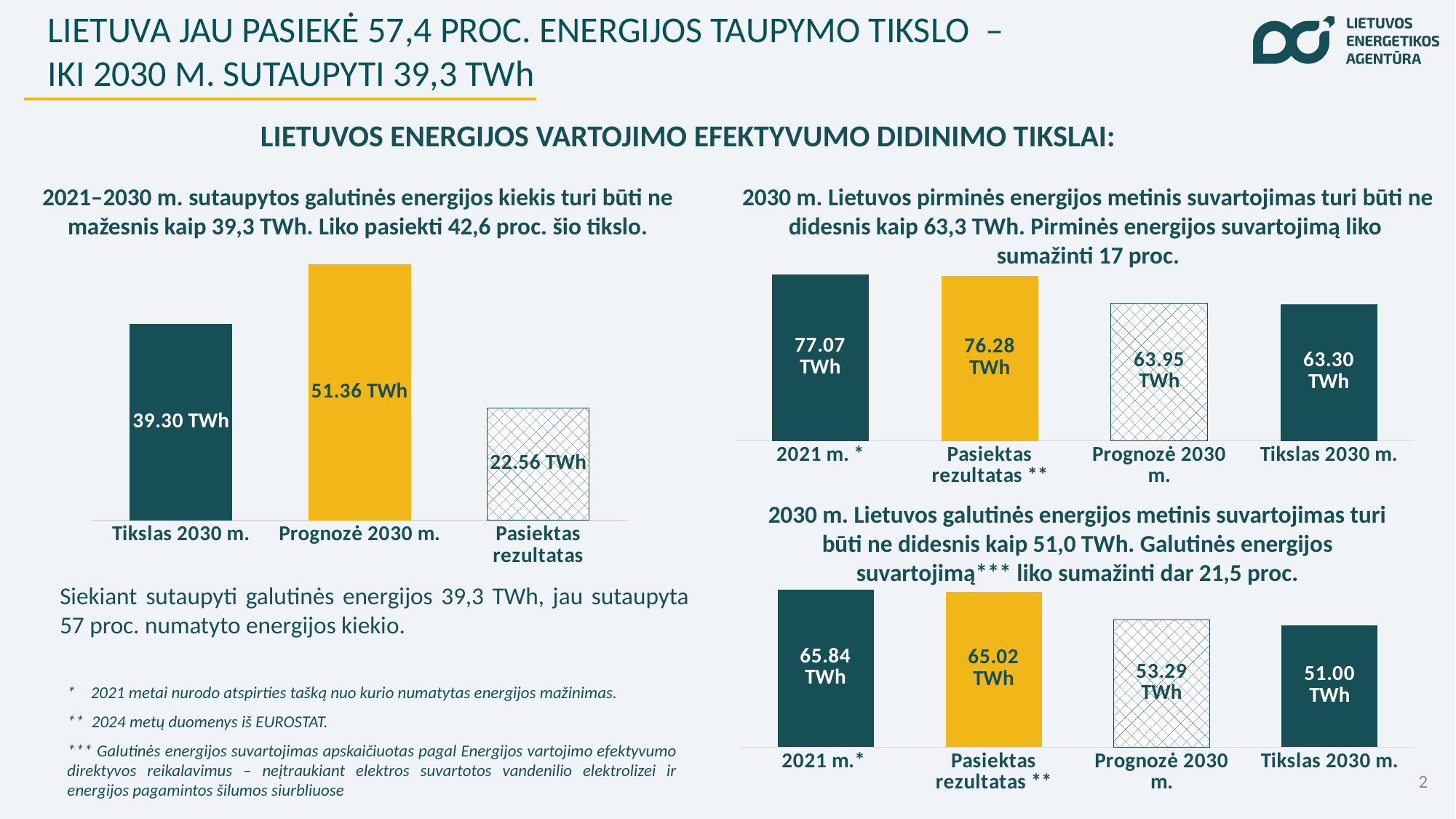
On the left chart, which category has the lowest value? Pasiektas rezultatas On the top-right chart, what is the difference between Prognozė 2030 m. and Tikslas 2030 m.? 0.65 TWh How many bars does the left chart have? 3 On the top-right chart, which category has the highest value? 2021 m. On the left chart, what is the difference between Prognozė 2030 m. and Tikslas 2030 m.? 12.06 TWh On the bottom-right chart, which is larger: Prognozė 2030 m. or Tikslas 2030 m.? Prognozė 2030 m. On the top-right chart, do the values rise or fall from left to right? Fall On the bottom-right chart, what is the value for Pasiektas rezultatas? 65.02 TWh On the bottom-right chart, what is the difference between 2021 m. and Tikslas 2030 m.? 14.84 TWh On the top-right chart, what is the value for 2021 m.? 77.07 TWh On the left chart, what is the value for Prognozė 2030 m.? 51.36 TWh What type of chart is the left chart? Bar chart